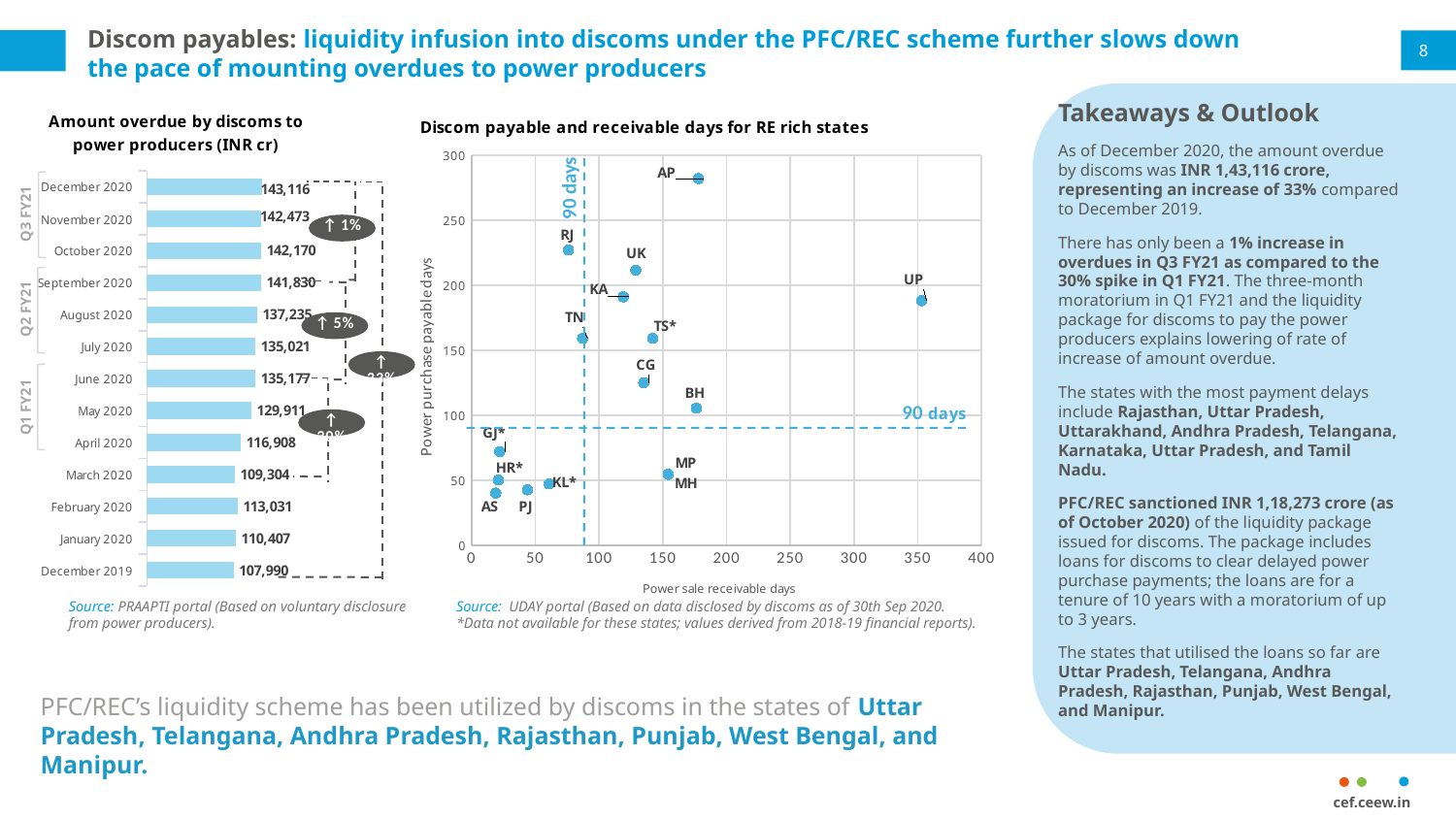
What kind of chart is 'Amount overdue by discoms to power producers (INR cr)'? Bar chart In the chart 'Amount overdue by discoms to power producers (INR cr)', which is larger: the value for February 2020 or March 2020? February 2020 What kind of chart is 'Discom payable and receivable days for RE rich states'? Scatter chart In the chart 'Amount overdue by discoms to power producers (INR cr)', what is the value for December 2020? 143,116 In the chart 'Discom payable and receivable days for RE rich states', are the power purchase payable days for AP greater or less than 250? greater In the chart 'Amount overdue by discoms to power producers (INR cr)', which month has the lowest amount overdue? December 2019 In the chart 'Amount overdue by discoms to power producers (INR cr)', what is the difference between the December 2020 and December 2019 values? 35,126 In the chart 'Amount overdue by discoms to power producers (INR cr)', which month has the highest amount overdue? December 2020 In the chart 'Discom payable and receivable days for RE rich states', are the power sale receivable days for UP greater or less than 300? greater In the chart 'Discom payable and receivable days for RE rich states', what value do the dashed reference lines mark on both axes? 90 days How many months are shown in the chart 'Amount overdue by discoms to power producers (INR cr)'? 13 In the chart 'Amount overdue by discoms to power producers (INR cr)', what is the value for April 2020? 116,908